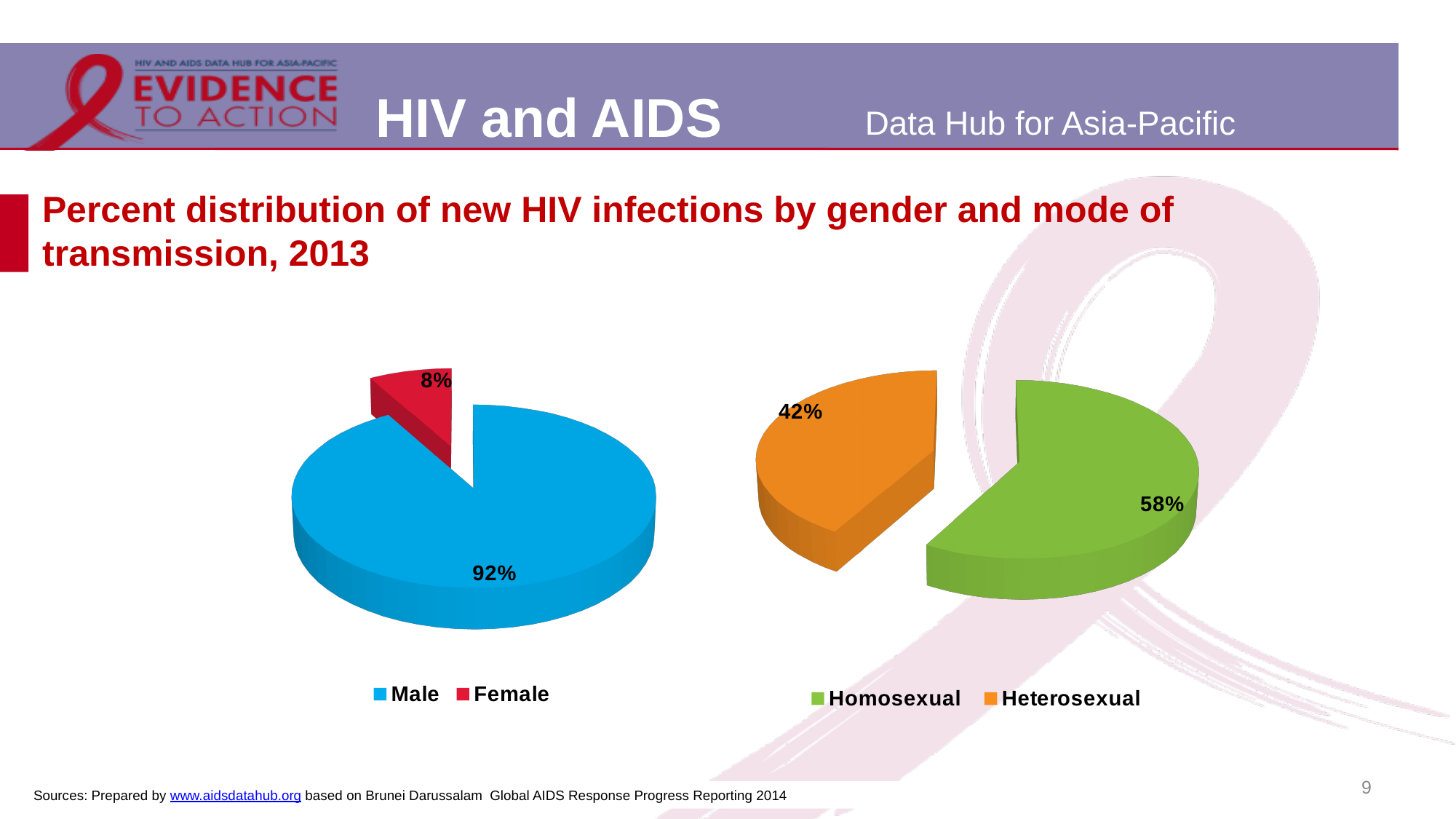
How many slices does the left pie chart (gender) have? 2 In the left pie chart (gender), which category has the largest share? Male In the right pie chart (mode of transmission), what is the difference in percentage points between Homosexual and Heterosexual? 16 What type of chart is used on the right to show mode of transmission? Pie chart In the left pie chart (gender), what percentage of new HIV infections is Male? 92% In the left pie chart (gender), what percentage of new HIV infections is Female? 8% In the right pie chart (mode of transmission), which category has the smallest share? Heterosexual In the right pie chart (mode of transmission), what percentage is Homosexual? 58% In the left pie chart (gender), what is the difference in percentage points between Male and Female? 84 In the left pie chart (gender), what colour is the Female slice? Red In the right pie chart (mode of transmission), which is larger, Homosexual or Heterosexual? Homosexual In the right pie chart (mode of transmission), what percentage is Heterosexual? 42%